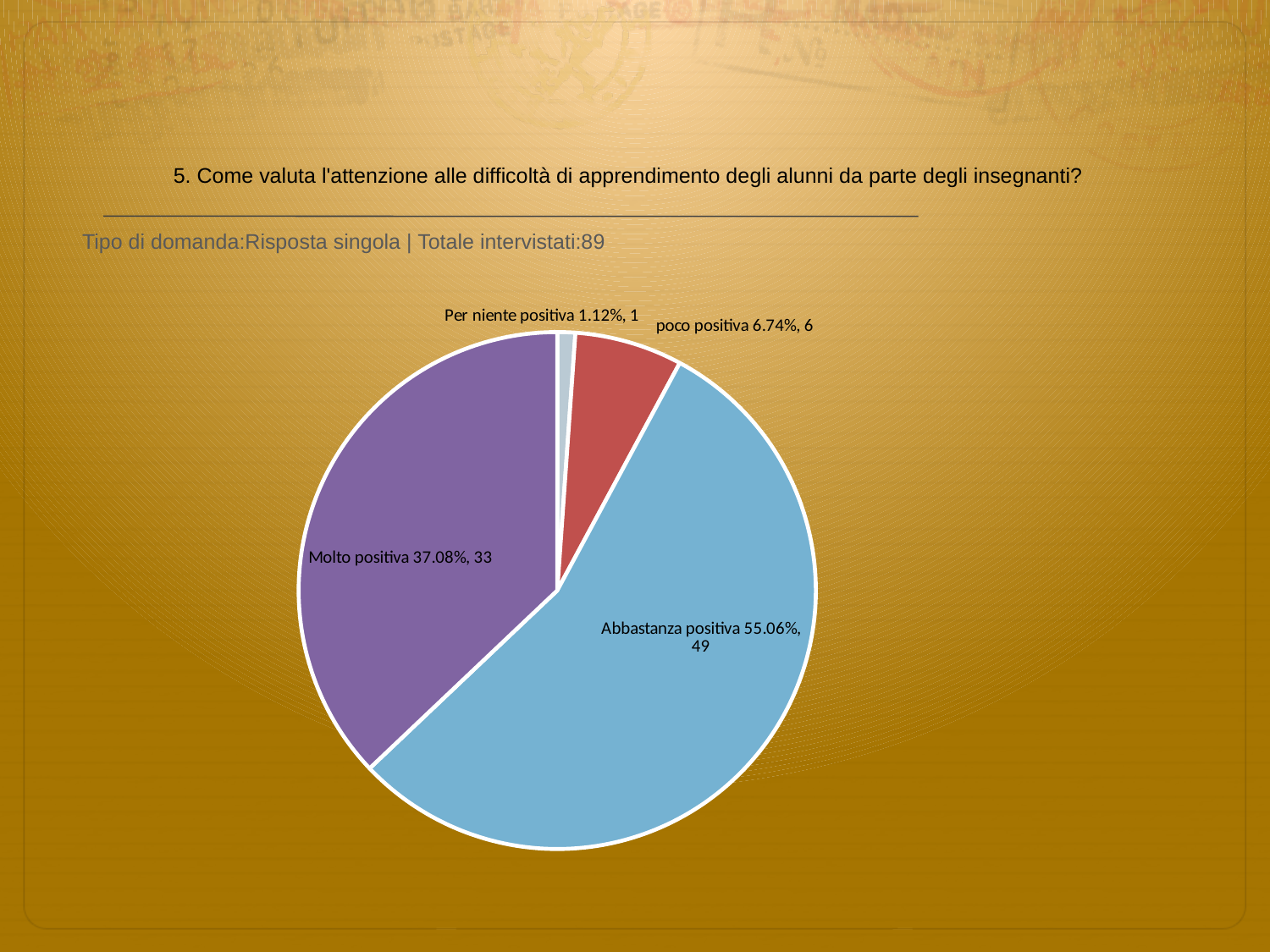
How many respondents answered 'Per niente positiva'? 1 What percentage share does the 'poco positiva' slice have? 6.74% Which category has the largest slice of the pie? Abbastanza positiva What kind of chart is shown on the slide? pie chart Which category has the smallest slice of the pie? Per niente positiva What is the difference in respondent count between 'Abbastanza positiva' and 'Molto positiva'? 16 How many slices does the pie chart have? 4 What percentage share does the 'Abbastanza positiva' slice have? 55.06% What is the total number of respondents across all slices? 89 How many respondents answered 'Molto positiva'? 33 Which has more respondents, 'poco positiva' or 'Per niente positiva'? poco positiva What colour is the 'Molto positiva' slice? purple